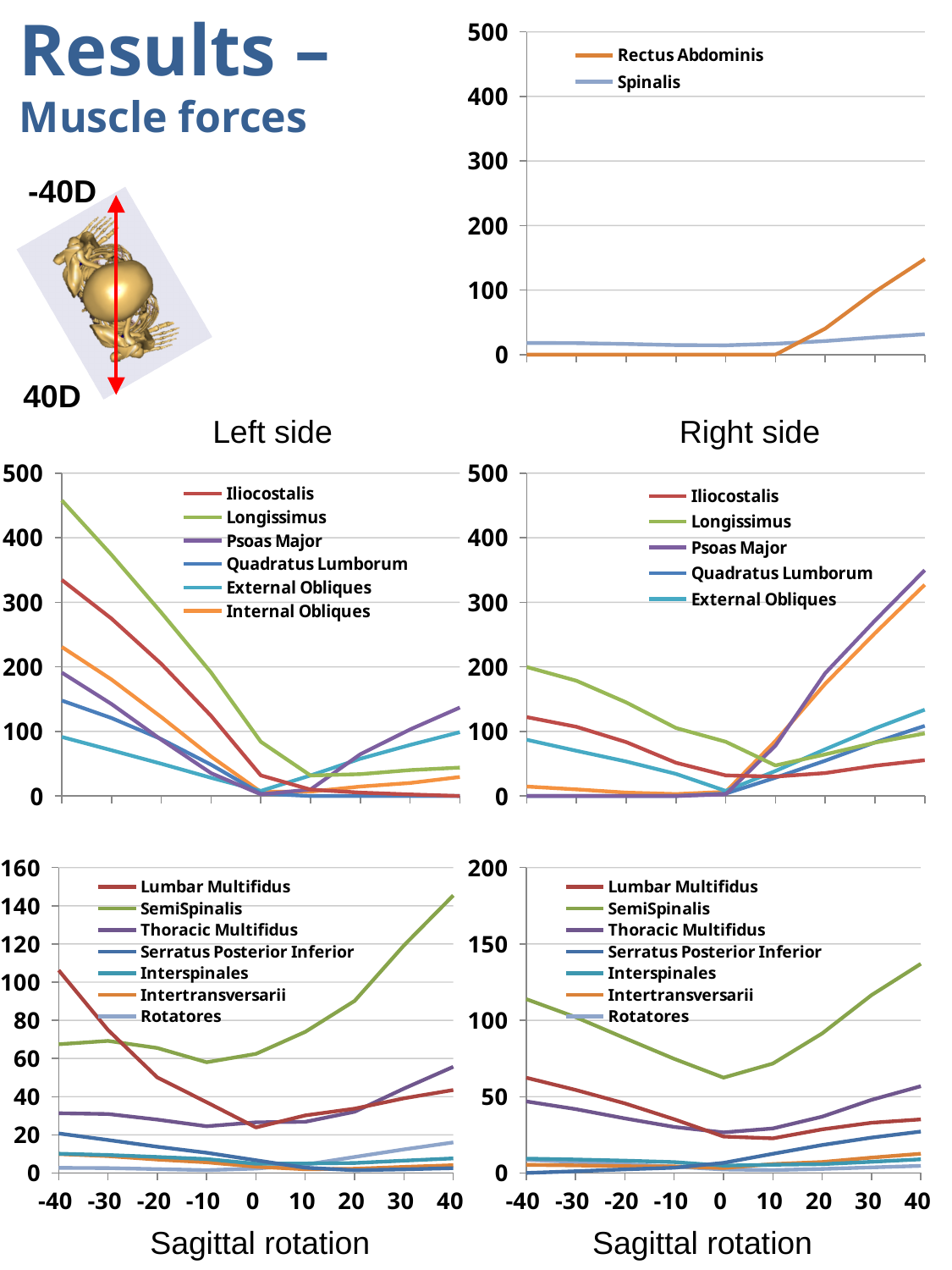
In the upper Left side chart, which series has the highest value at -40 sagittal rotation? Longissimus In the lower Right side chart, is the value for SemiSpinalis at 40 greater or less than 100? greater In the upper Left side chart, how many series does the legend list? 6 In the upper Right side chart, how many series does the legend list? 5 In the top-right chart, how many series does the legend list? 2 In the upper Right side chart, is the value for Psoas Major at 40 greater or less than 300? greater What kind of chart is the top-right chart with Rectus Abdominis and Spinalis? Line chart In the upper Right side chart, at -40 sagittal rotation, which is larger: Longissimus or Iliocostalis? Longissimus In the upper Left side chart, is the value for Longissimus at -40 greater or less than 400? greater What is the x-axis title shown under the lower charts? Sagittal rotation In the top-right chart, does the Rectus Abdominis line rise or fall between 10 and 40 sagittal rotation? rises